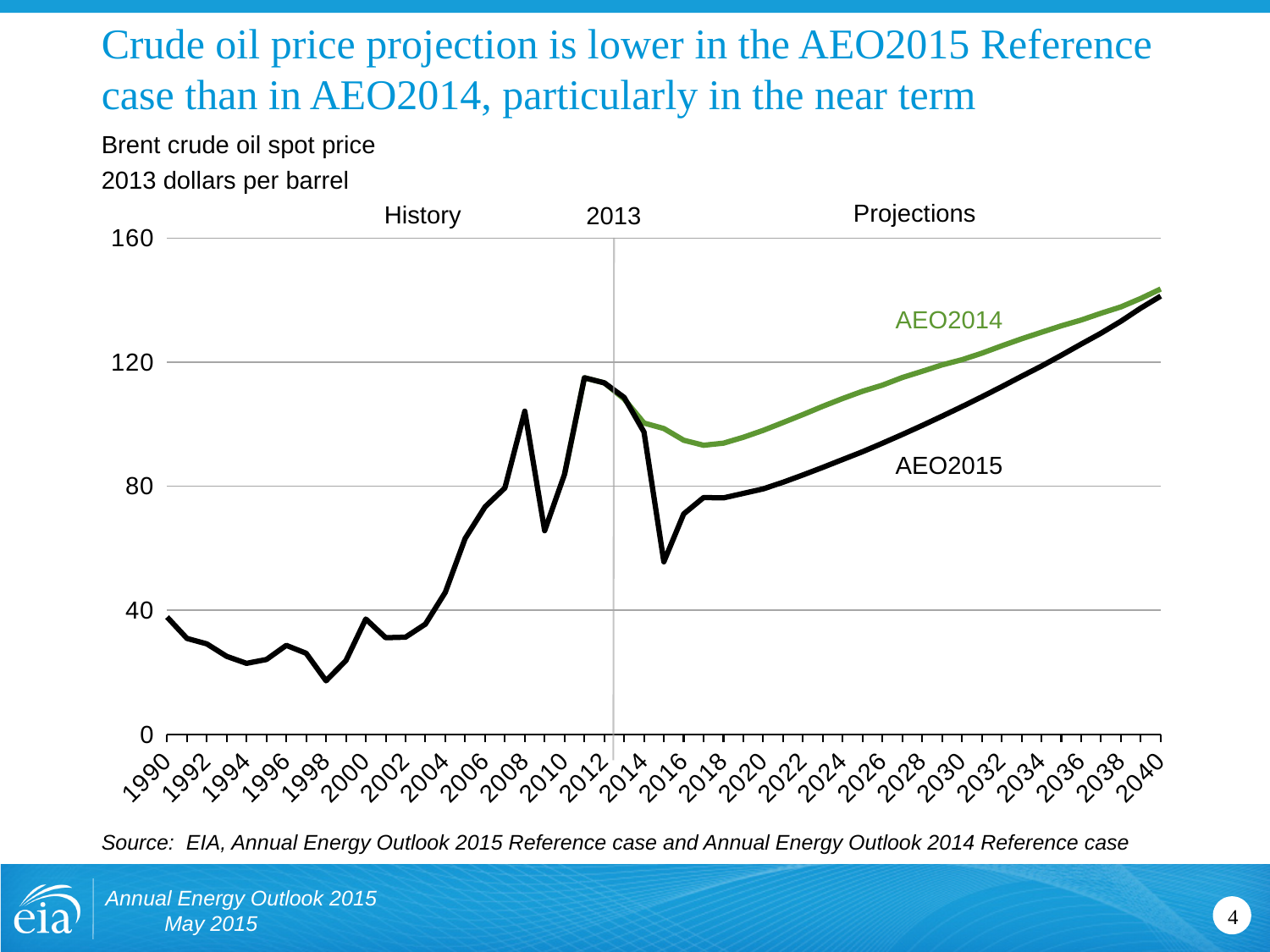
Is the historical value in 1998 greater or less than 40? less Which series is higher in 2030, AEO2014 or AEO2015? AEO2014 Does the historical price rise or fall between 1990 and 1998? fall Is the AEO2015 value in 2016 greater or less than 80? less Is the AEO2014 value in 2020 greater or less than 80? greater How many projection series are labeled on the chart? 2 Does the AEO2015 projection rise or fall between 2020 and 2040? rise Which series is higher in 2020, AEO2014 or AEO2015? AEO2014 What kind of chart is shown on the slide? line chart In what units is the price measured on the chart? 2013 dollars per barrel